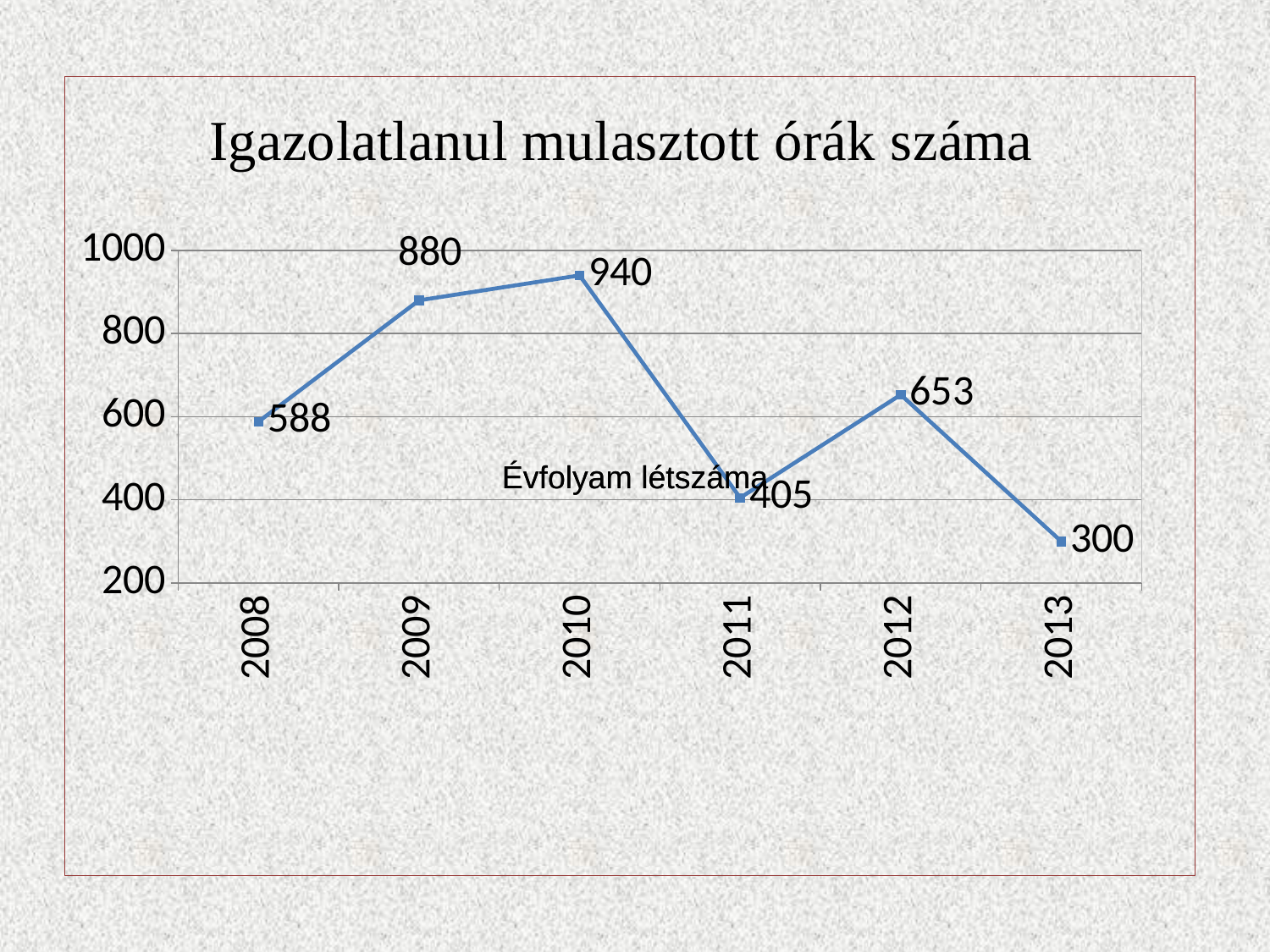
What is the title of the chart? Igazolatlanul mulasztott órák száma How many years are plotted on the chart? 6 Which is larger, the value for 2011 or the value for 2012? 2012 What is the value for 2013? 300 What kind of chart is shown on the slide? line chart Which year has the highest value? 2010 What is the value for 2008? 588 What is the difference between the values for 2009 and 2008? 292 Do the values rise or fall from 2010 to 2011? fall Which year has the lowest value? 2013 What is the value for 2010? 940 What is the difference between the values for 2012 and 2011? 248